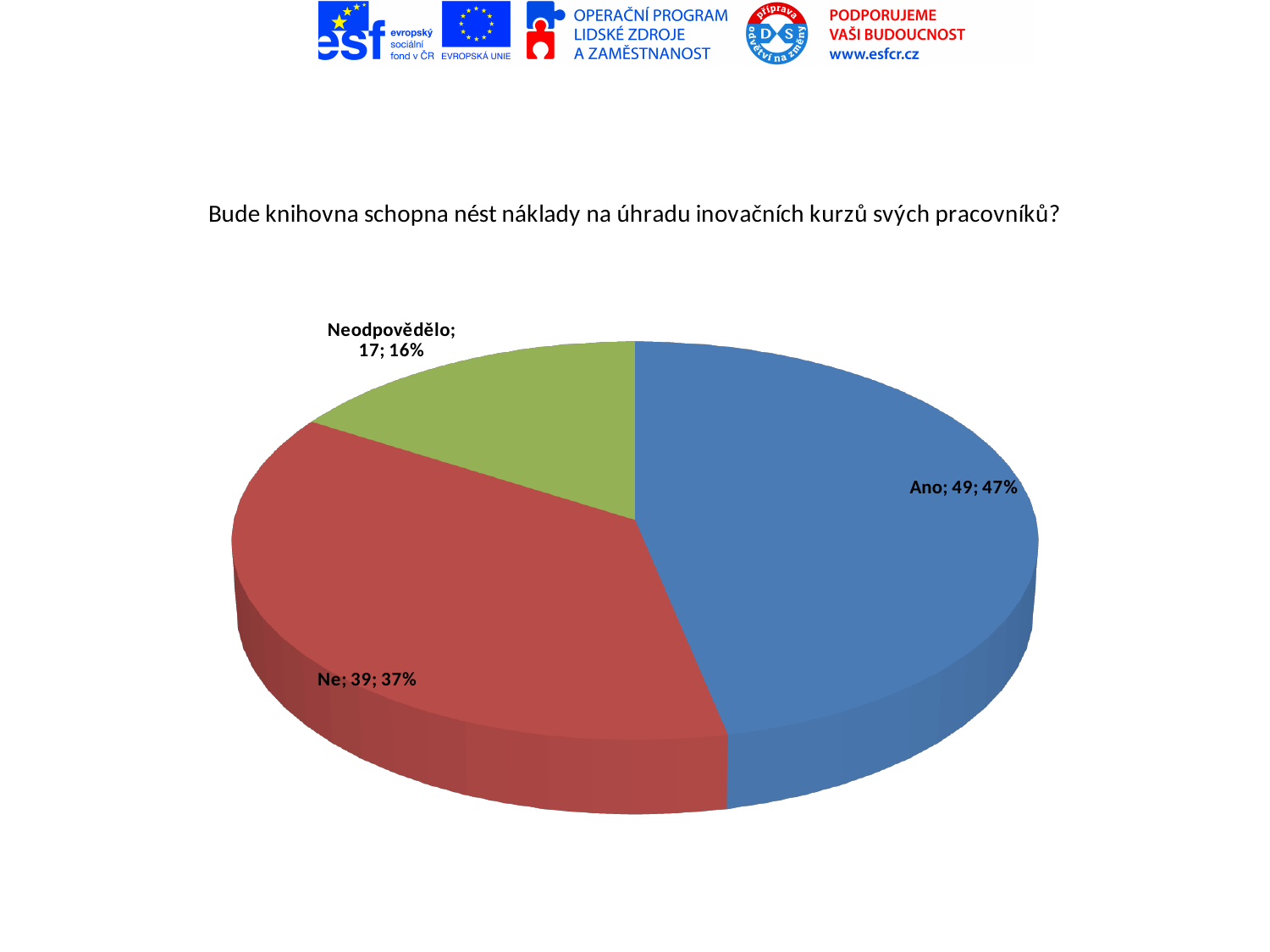
How many slices does the pie chart have? 3 What share of the pie does 'Ano' represent? 47% What is the count for the 'Ne' slice? 39 What kind of chart is shown on the slide? pie chart Which category has the smallest slice? Neodpovědělo Which category has the largest slice? Ano What share of the pie does 'Neodpovědělo' represent? 16% What is the count for the 'Neodpovědělo' slice? 17 What is the count for the 'Ano' slice? 49 What is the title of the chart? Bude knihovna schopna nést náklady na úhradu inovačních kurzů svých pracovníků? What is the difference between the counts for 'Ano' and 'Ne'? 10 Which colour is the 'Ne' slice? red